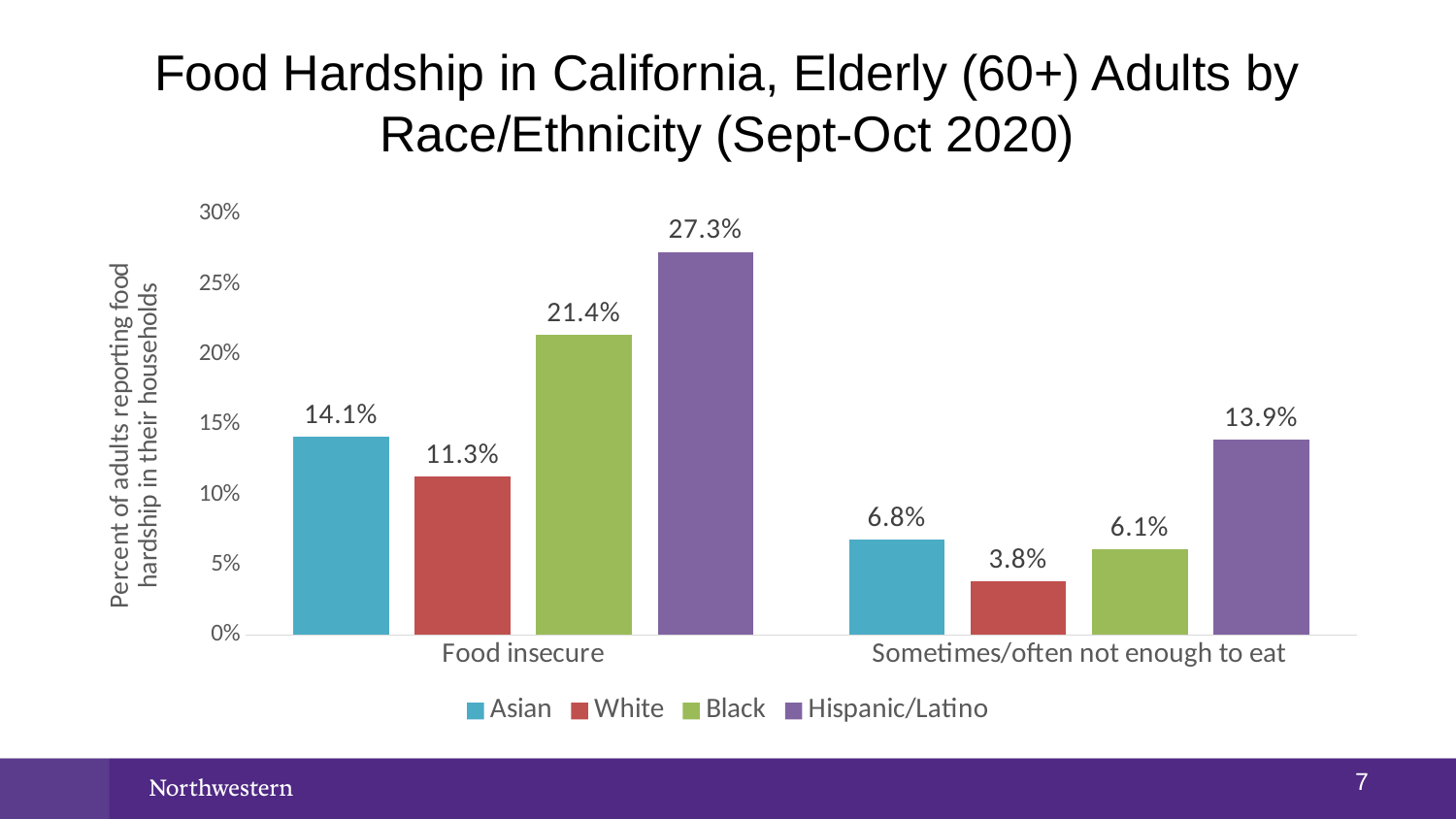
How many series does the legend list? 4 Which group has the lowest value in the Sometimes/often not enough to eat category? White Is the value for Black in the Food insecure category greater or less than 20%? greater Which group has the highest value in the Food insecure category? Hispanic/Latino What is the difference between the Black and White values in the Food insecure category? 10.1% What is the value for Hispanic/Latino in the Food insecure category? 27.3% What is the label of the y axis? Percent of adults reporting food hardship in their households What kind of chart is shown on the slide? Bar chart What is the value for White in the Sometimes/often not enough to eat category? 3.8% Which is larger in the Sometimes/often not enough to eat category: Asian or Black? Asian What is the value for Asian in the Food insecure category? 14.1% How many categories are shown on the x axis? 2